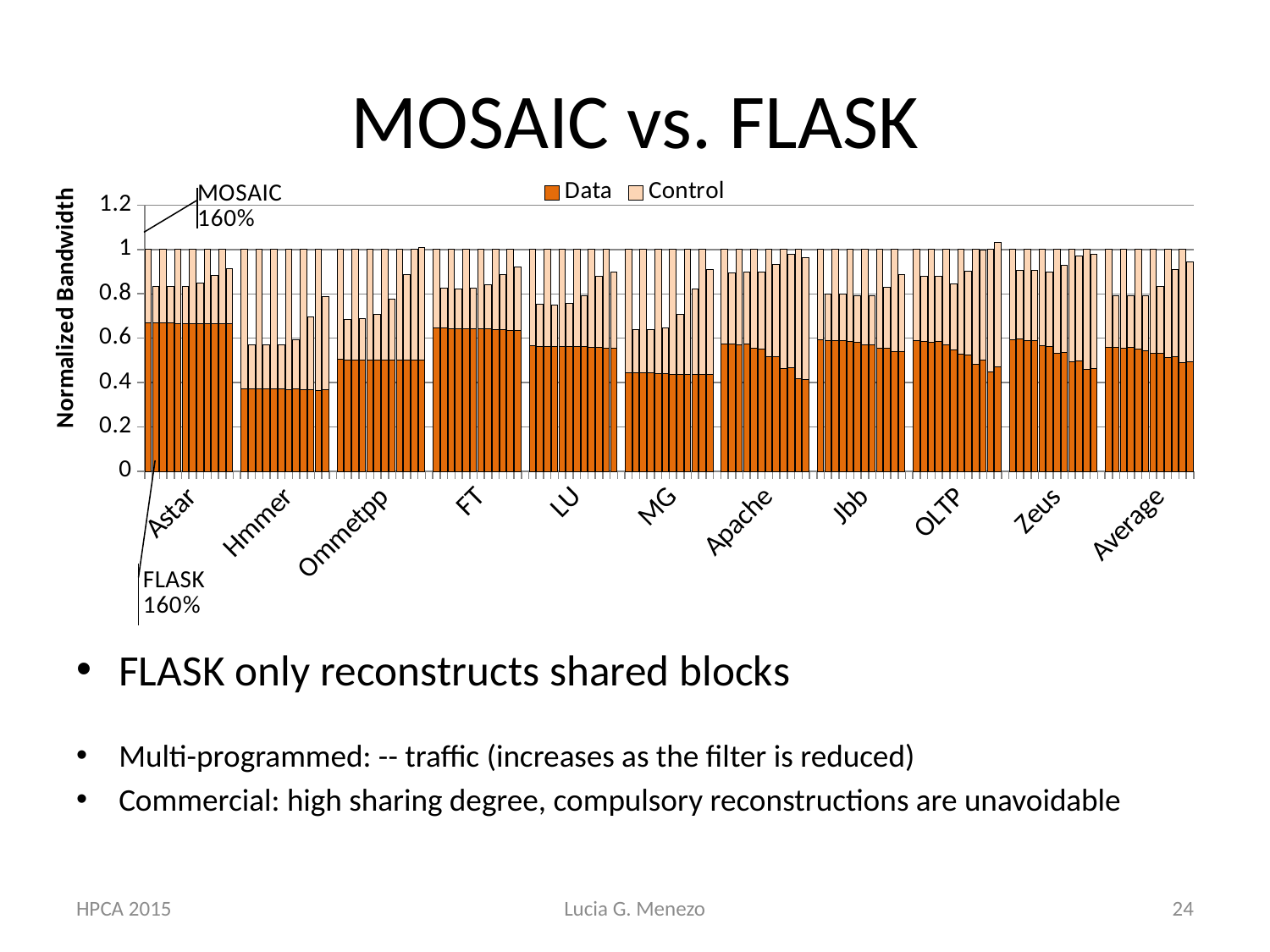
What kind of chart is shown on the slide? stacked bar chart What are the two series named in the chart legend? Data and Control What is the title of the y axis of the chart? Normalized Bandwidth Is the Data value for MG greater or less than 0.6? less Is the Data value for Astar greater or less than 0.6? greater Which benchmark has the lowest Data bars in the chart? Hmmer How many series does the chart legend list? 2 Is the Data value for Hmmer greater or less than 0.4? less What value is annotated for FLASK below the chart? 160% How many benchmark categories are labelled along the x axis of the chart? 11 Is the Data value for Astar larger or smaller than the Data value for Hmmer? larger What value is annotated for MOSAIC at the top-left of the chart? 160%